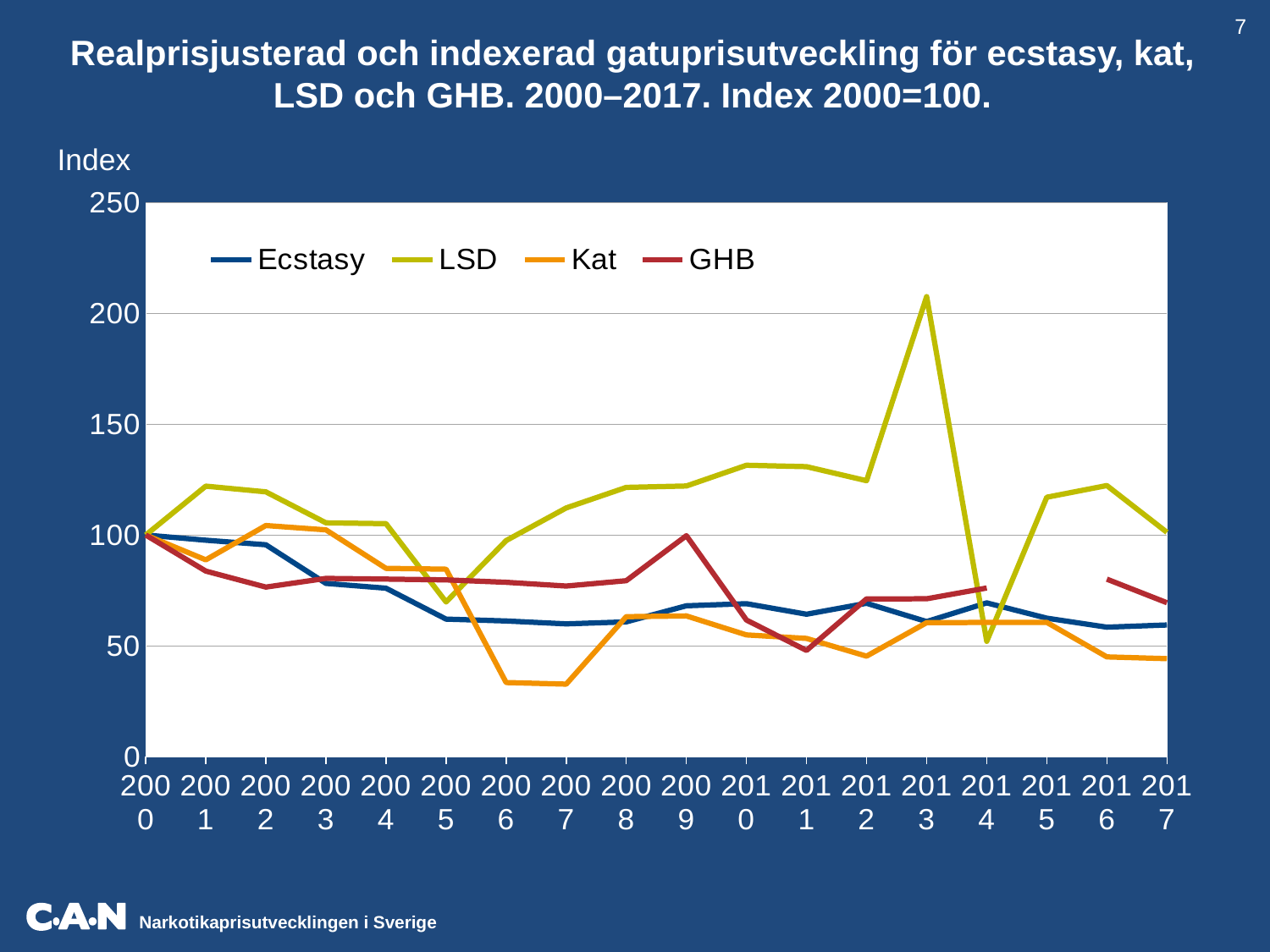
How many series does the legend list? 4 In which year does LSD reach its highest value? 2013 Does the Ecstasy line rise or fall from 2000 to 2005? fall What is the index value for Ecstasy in 2000? 100 Is the value for Kat in 2006 greater or less than 50? less Which series reaches the highest value in 2013? LSD Which series is drawn in orange in the legend? Kat Is the value for Ecstasy in 2017 greater or less than 100? less What kind of chart is shown on the slide? line chart Is the value for LSD in 2013 greater or less than 200? greater How many years are plotted along the x axis? 18 Which is larger in 2006, the value for LSD or the value for Kat? LSD